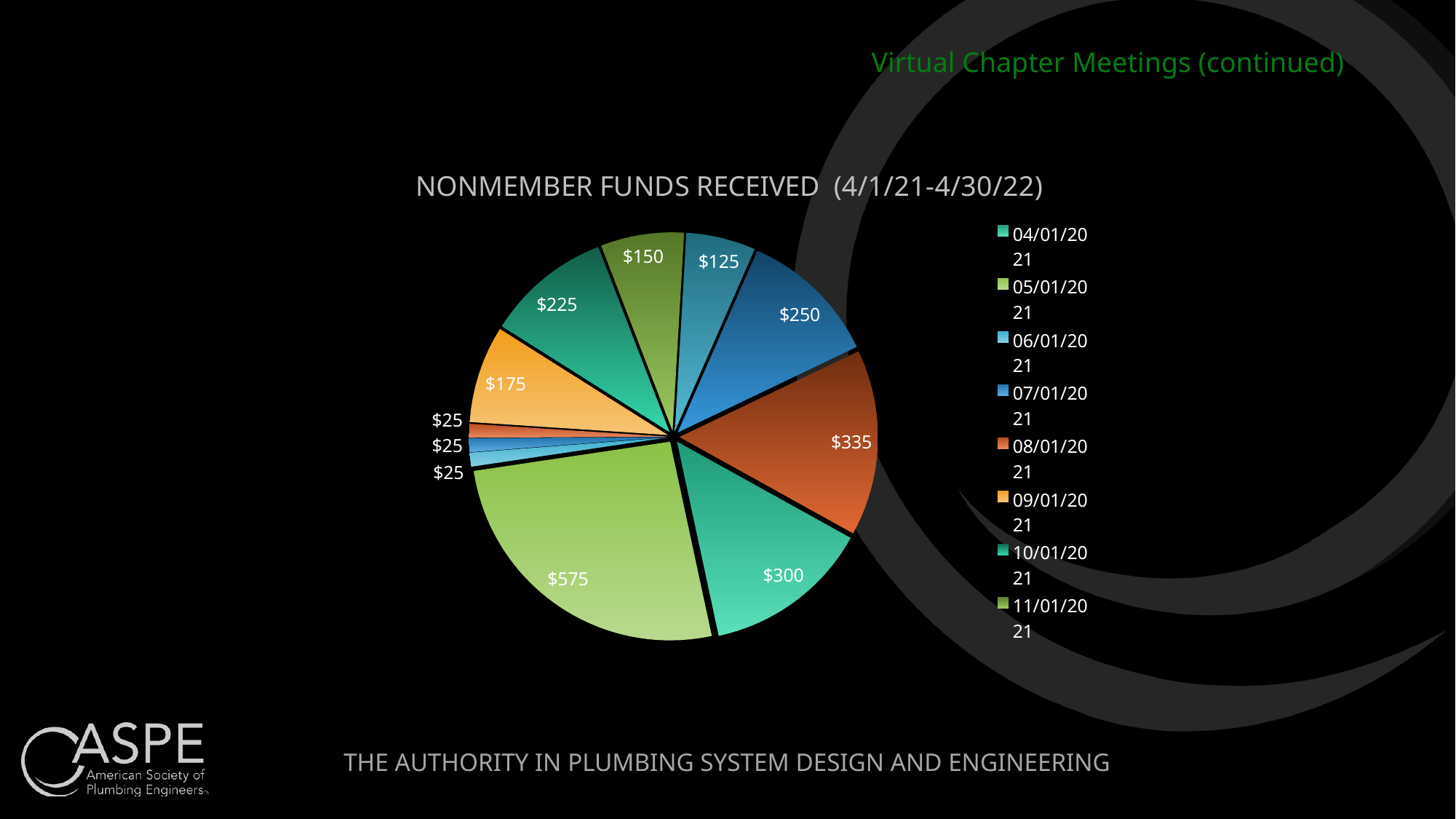
How many slices does the pie chart have? 11 What is the value of the smallest slices in the pie chart? $25 What is the value of the largest slice in the pie chart? $575 How many slices in the pie chart are labelled $25? 3 What kind of chart is shown on the slide? Pie chart What is the first entry listed in the chart's legend? 04/01/2021 What is the total of all the slice values in the pie chart? $2,210 What is the title of the chart? NONMEMBER FUNDS RECEIVED (4/1/21-4/30/22) What share of the total does the $575 slice represent, to the nearest percent? 26% What is the difference between the $575 slice and the $335 slice? $240 Which is larger, the $300 slice or the $250 slice? $300 What is the difference between the $250 slice and the $125 slice? $125